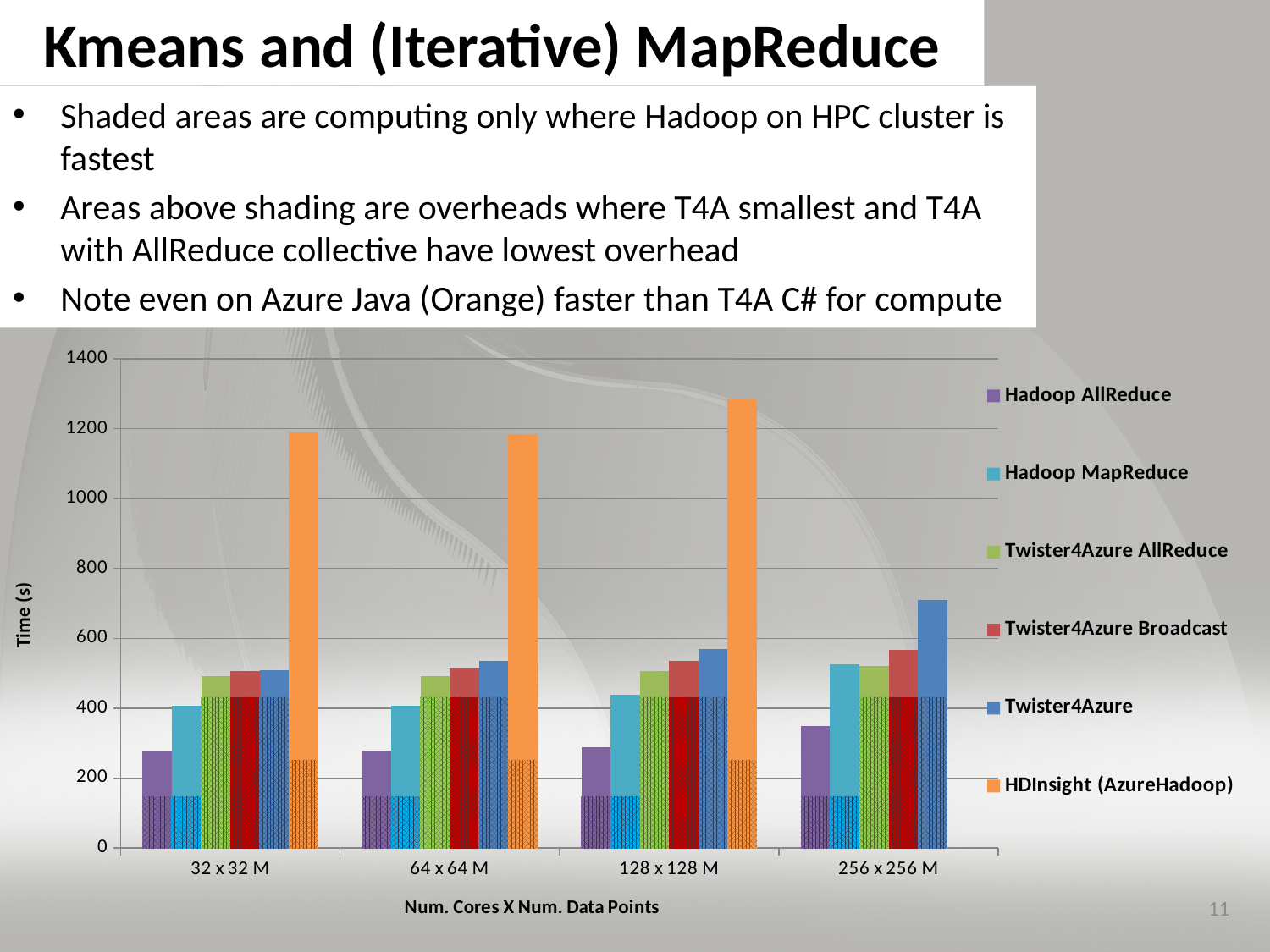
Which series has the lowest value for 128 x 128 M? Hadoop AllReduce Is the value for HDInsight (AzureHadoop) at 128 x 128 M greater or less than 1200? greater Is the value for Hadoop AllReduce at 32 x 32 M greater or less than 400? less Is the value for Twister4Azure at 256 x 256 M greater or less than 600? greater What is the title of the y axis? Time (s) Which series has the highest value for 32 x 32 M? HDInsight (AzureHadoop) What kind of chart is shown on the slide? bar chart How many categories are shown on the x axis? 4 At 256 x 256 M, which is larger: Twister4Azure or Hadoop MapReduce? Twister4Azure Do the values for Twister4Azure rise or fall from 32 x 32 M to 256 x 256 M? rise At 256 x 256 M, which is larger: Hadoop AllReduce or Hadoop MapReduce? Hadoop MapReduce How many series does the legend list? 6